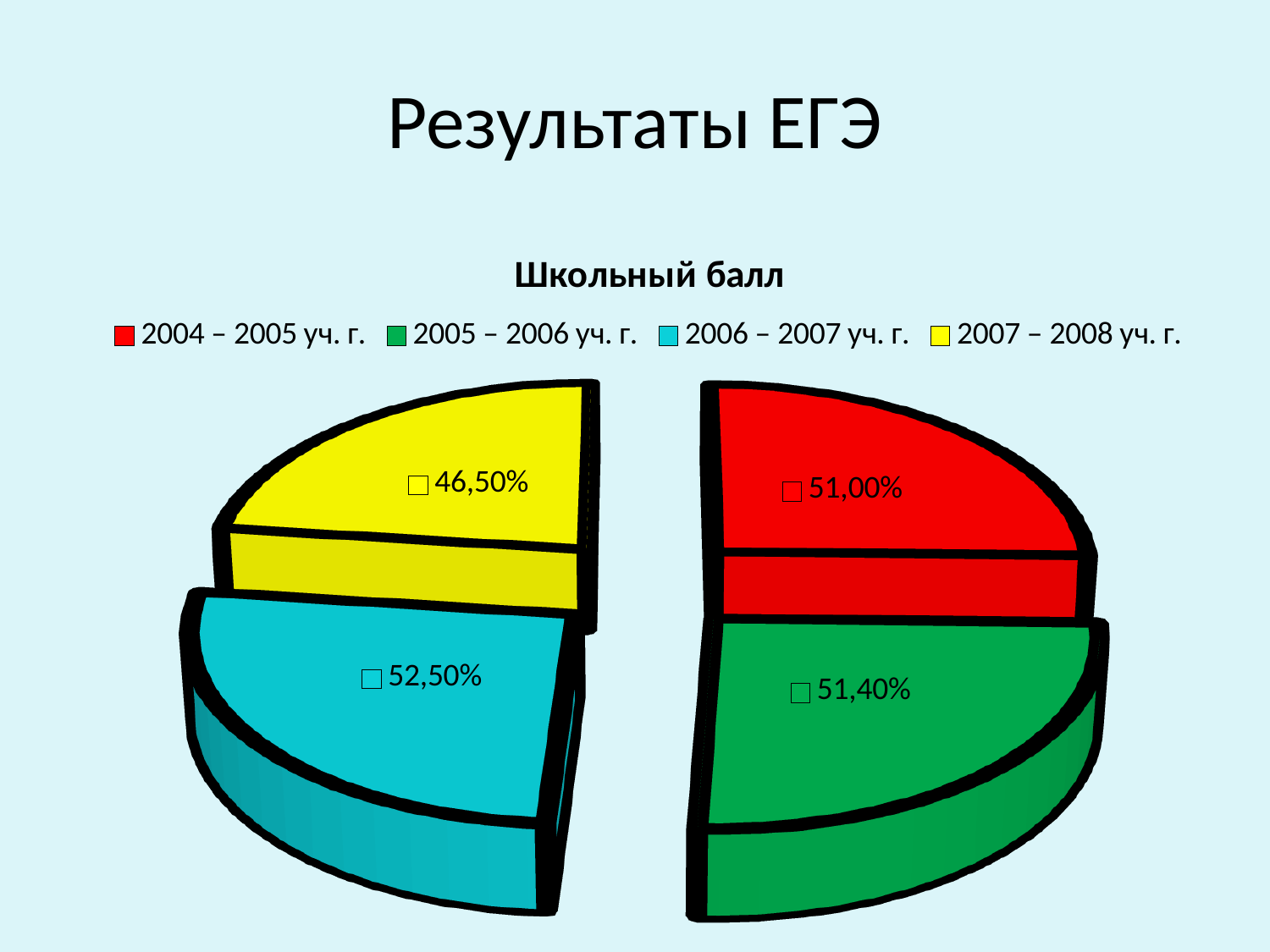
What is the title of the chart? Школьный балл What is the value shown for 2005 – 2006 уч. г.? 51,40% What is the difference between the values for 2006 – 2007 уч. г. and 2007 – 2008 уч. г.? 6,00% Which has the larger value, 2004 – 2005 уч. г. or 2007 – 2008 уч. г.? 2004 – 2005 уч. г. What kind of chart is shown on the slide? Pie chart What is the difference between the values for 2005 – 2006 уч. г. and 2004 – 2005 уч. г.? 0,40% What is the value shown for 2004 – 2005 уч. г.? 51,00% How many slices does the pie chart have? 4 Which school year has the lowest value in the chart? 2007 – 2008 уч. г. What is the value shown for 2007 – 2008 уч. г.? 46,50% What is the value shown for 2006 – 2007 уч. г.? 52,50% Which school year has the highest value in the chart? 2006 – 2007 уч. г.